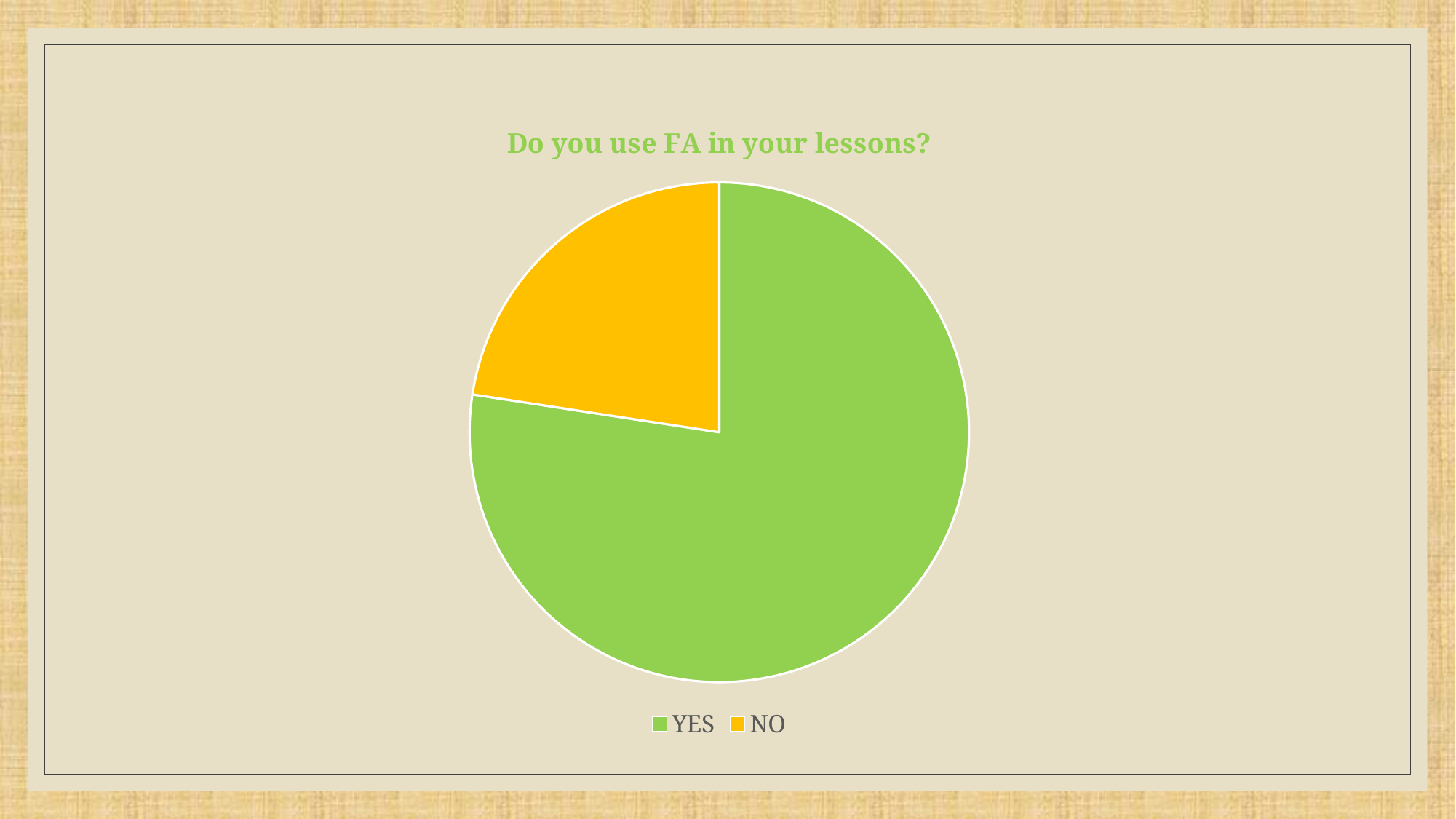
What kind of chart is shown on the slide? pie chart How many entries does the legend list? 2 How many slices does the pie chart have? 2 What colour is the YES slice? green Which slice is the largest in the pie chart? YES Which slice is larger, YES or NO? YES Does the YES slice take up more or less than half of the pie? more Which slice is the smallest in the pie chart? NO What is the title of the chart? Do you use FA in your lessons?